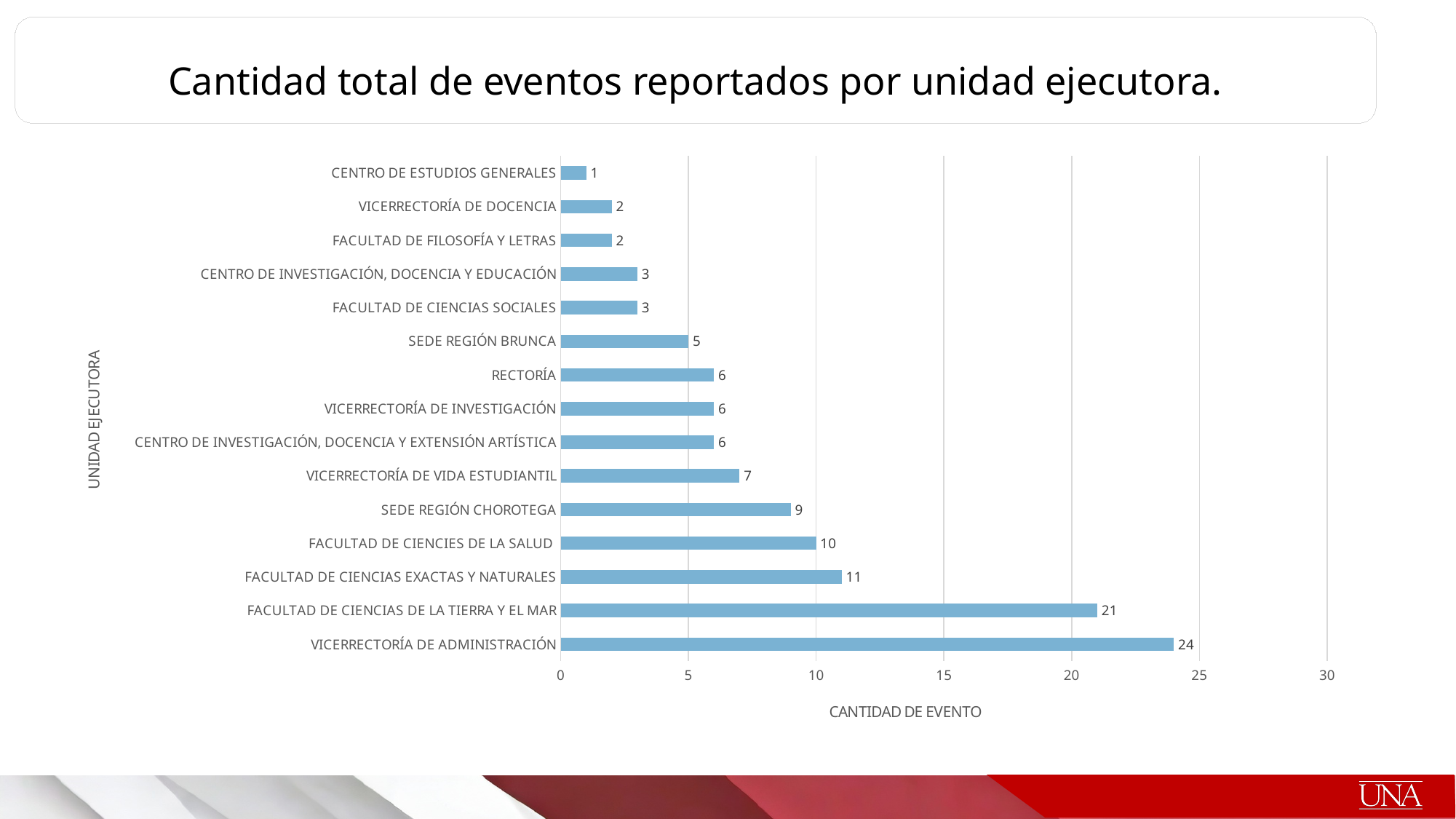
What is the difference between the values for VICERRECTORÍA DE ADMINISTRACIÓN and FACULTAD DE CIENCIAS DE LA TIERRA Y EL MAR? 3 Which unit has the highest number of reported events? VICERRECTORÍA DE ADMINISTRACIÓN What is the label of the horizontal axis? CANTIDAD DE EVENTO Is the value for FACULTAD DE CIENCIAS DE LA TIERRA Y EL MAR greater or less than 20? greater How many events are reported for VICERRECTORÍA DE ADMINISTRACIÓN? 24 Which unit has the lowest number of reported events? CENTRO DE ESTUDIOS GENERALES How many units (categories) are shown in the chart? 15 What is the title of the chart? Cantidad total de eventos reportados por unidad ejecutora. What is the value for FACULTAD DE CIENCIAS EXACTAS Y NATURALES? 11 What is the value for SEDE REGIÓN CHOROTEGA? 9 Which has more reported events, SEDE REGIÓN BRUNCA or VICERRECTORÍA DE VIDA ESTUDIANTIL? VICERRECTORÍA DE VIDA ESTUDIANTIL What kind of chart is shown on the slide? bar chart